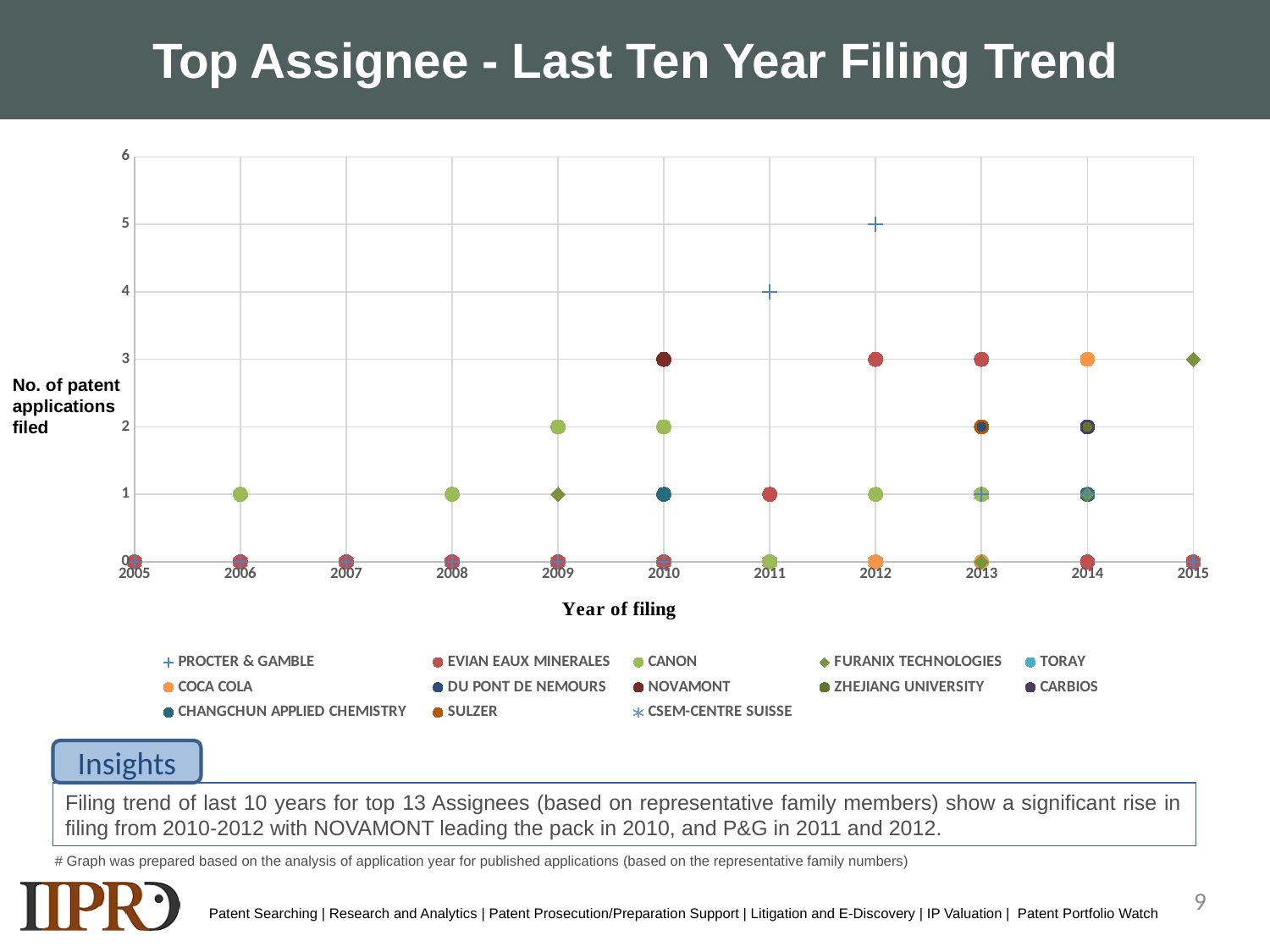
What kind of chart is shown on the slide? Scatter chart How many years are shown along the x axis? 11 What is the difference between PROCTER & GAMBLE's filings in 2012 and 2011? 1 How many patent applications did PROCTER & GAMBLE file in 2011? 4 How many patent applications did FURANIX TECHNOLOGIES file in 2015? 3 What is the title of the x axis? Year of filing How many patent applications did PROCTER & GAMBLE file in 2012? 5 How many patent applications did COCA COLA file in 2014? 3 Which assignee and year has the highest number of patent applications filed on the chart? PROCTER & GAMBLE in 2012 Which is larger: CANON's filings in 2009 or in 2006? 2009 How many patent applications did NOVAMONT file in 2010? 3 How many assignees does the legend list? 13